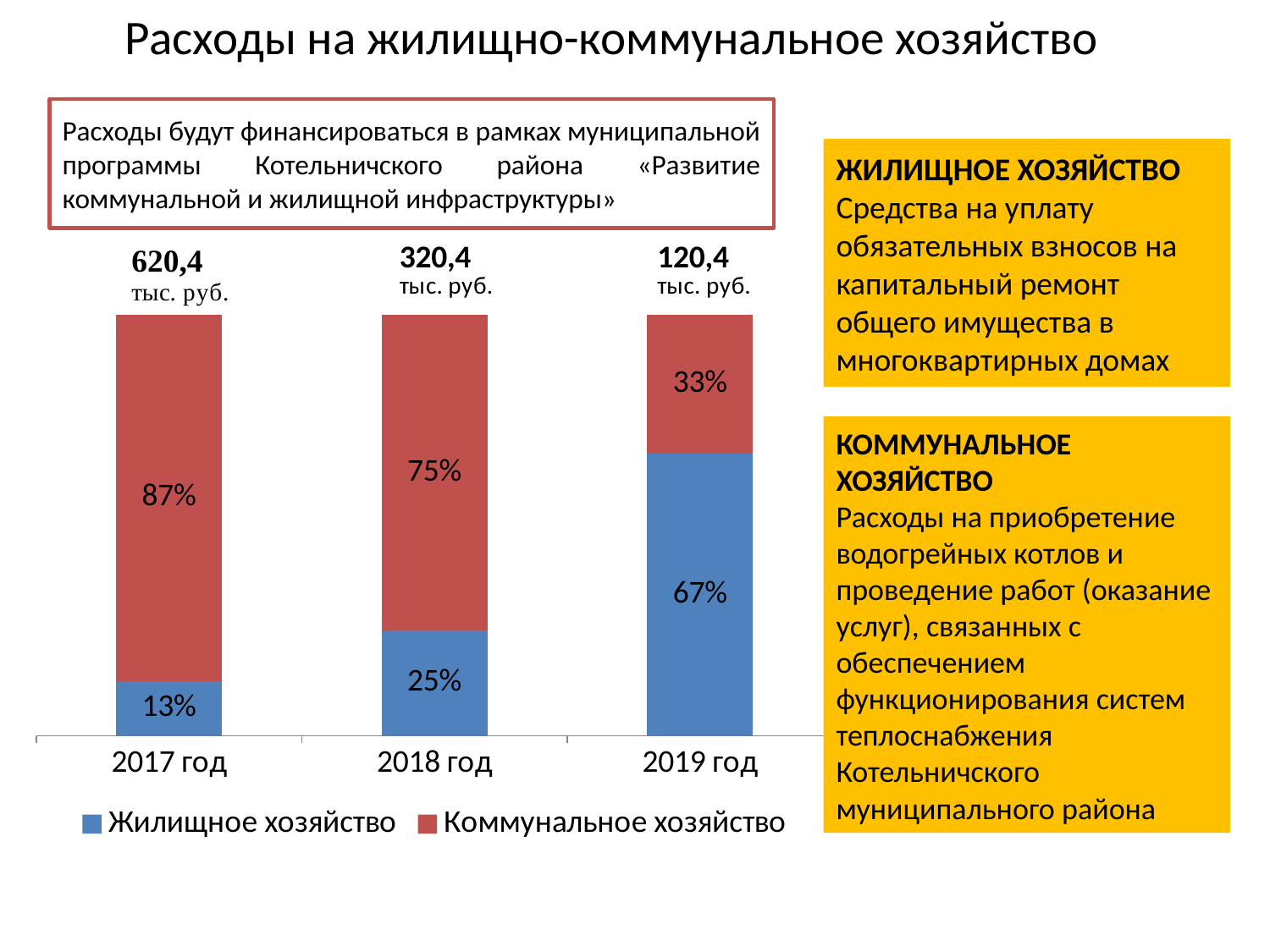
How many series does the legend list? 2 In which year is the share of Коммунальное хозяйство the highest? 2017 год What is the share of Коммунальное хозяйство in 2018 год? 75% What is the share of Жилищное хозяйство in 2017 год? 13% What is the share of Жилищное хозяйство in 2019 год? 67% Does the share of Жилищное хозяйство rise or fall from 2017 год to 2019 год? Rise What kind of chart is shown on the slide? Stacked bar chart How many years (categories) are shown on the x axis? 3 What total amount is printed above the bar for 2019 год? 120,4 тыс. руб. In which year is the share of Жилищное хозяйство the lowest? 2017 год What total amount is printed above the bar for 2017 год? 620,4 тыс. руб. What is the difference between the Коммунальное хозяйство share in 2017 год and in 2019 год? 54%